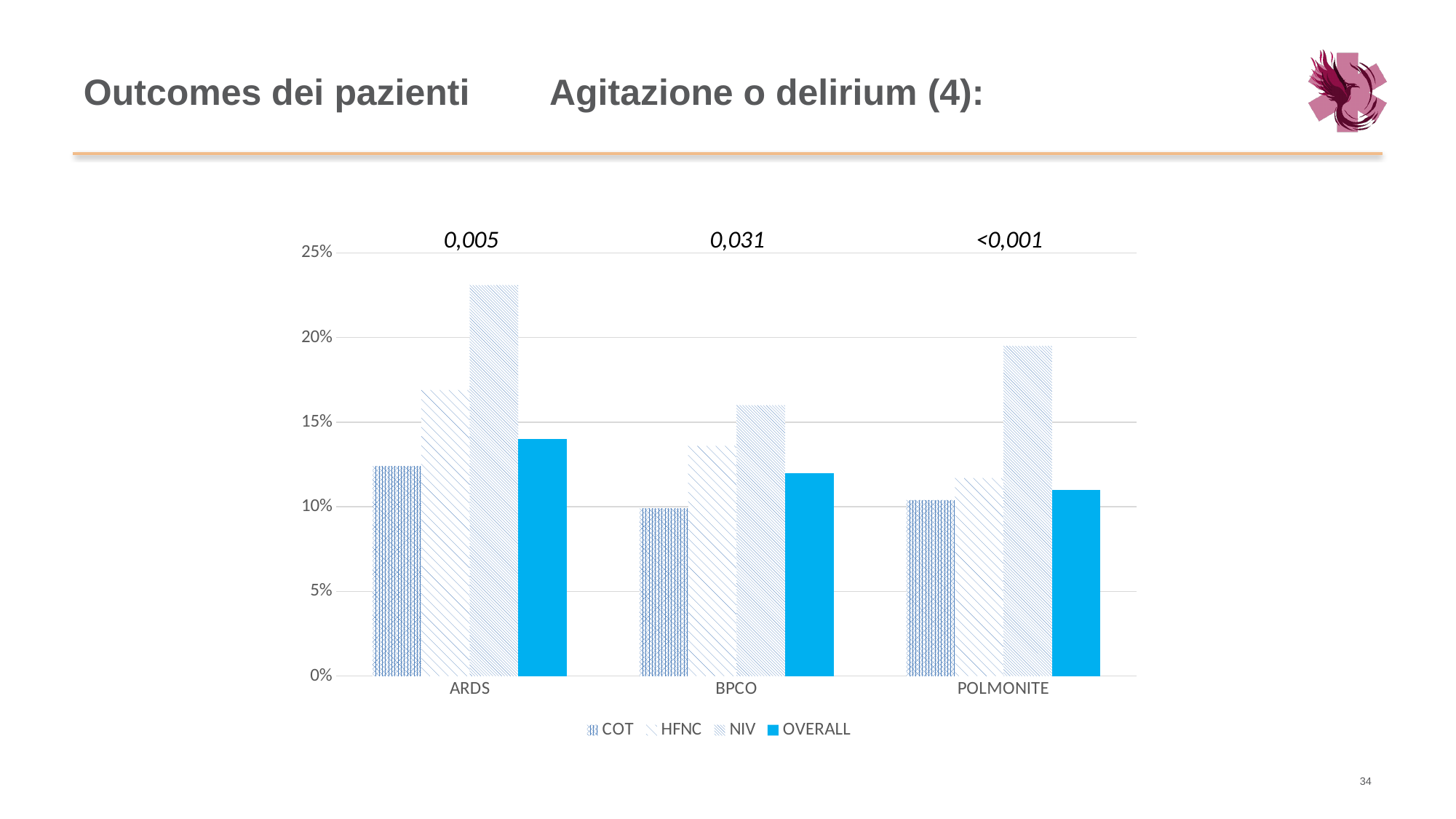
What p-value is printed above the POLMONITE group of bars? <0,001 Which is larger, the HFNC value for ARDS or the HFNC value for POLMONITE? ARDS Is the OVERALL value for BPCO greater or less than 15%? less How many series does the chart legend list? 4 How many categories are shown on the x axis of the chart? 3 Which series has the lowest value in the BPCO category? COT Which series has the highest value in the POLMONITE category? NIV Which is larger, the NIV value for BPCO or the NIV value for POLMONITE? POLMONITE What kind of chart is shown on the slide? bar chart Is the NIV value for ARDS greater or less than 20%? greater Which series has the highest value in the ARDS category? NIV Is the NIV value for POLMONITE greater or less than 15%? greater